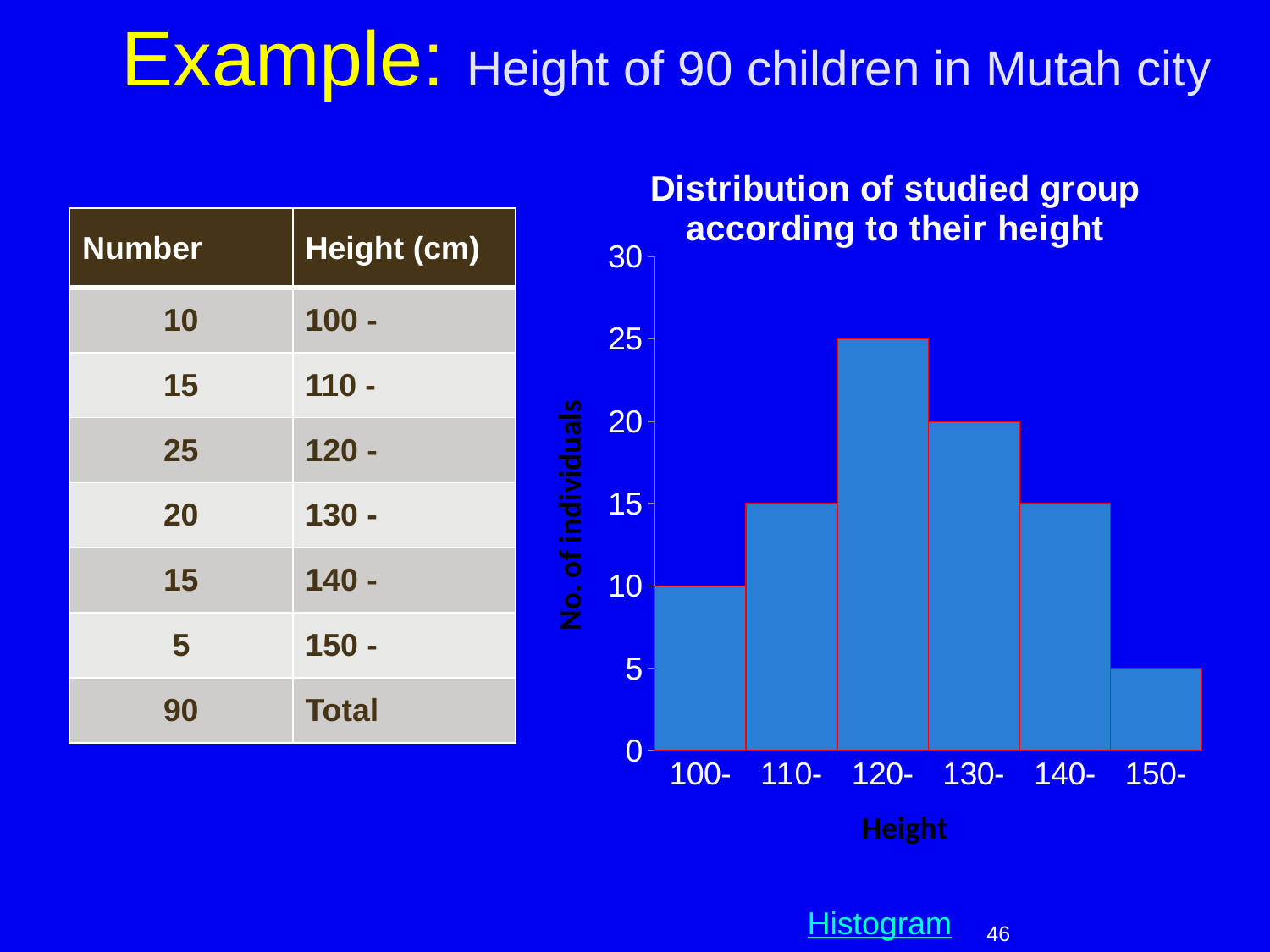
What is the title of the chart? Distribution of studied group according to their height Is the value for the 130- height group greater or less than 15? greater What is the number of individuals in the 100- height group? 10 Which height group has the lowest number of individuals? 150- What is the number of individuals in the 120- height group? 25 What is the number of individuals in the 150- height group? 5 How many height groups are shown on the x axis of the chart? 6 Which height group has the highest number of individuals? 120- What is the difference in number of individuals between the 120- and 130- height groups? 5 What is the label of the y axis of the chart? No. of individuals What kind of chart is shown on the slide? Bar chart (histogram) Which height group has more individuals, 110- or 130-? 130-